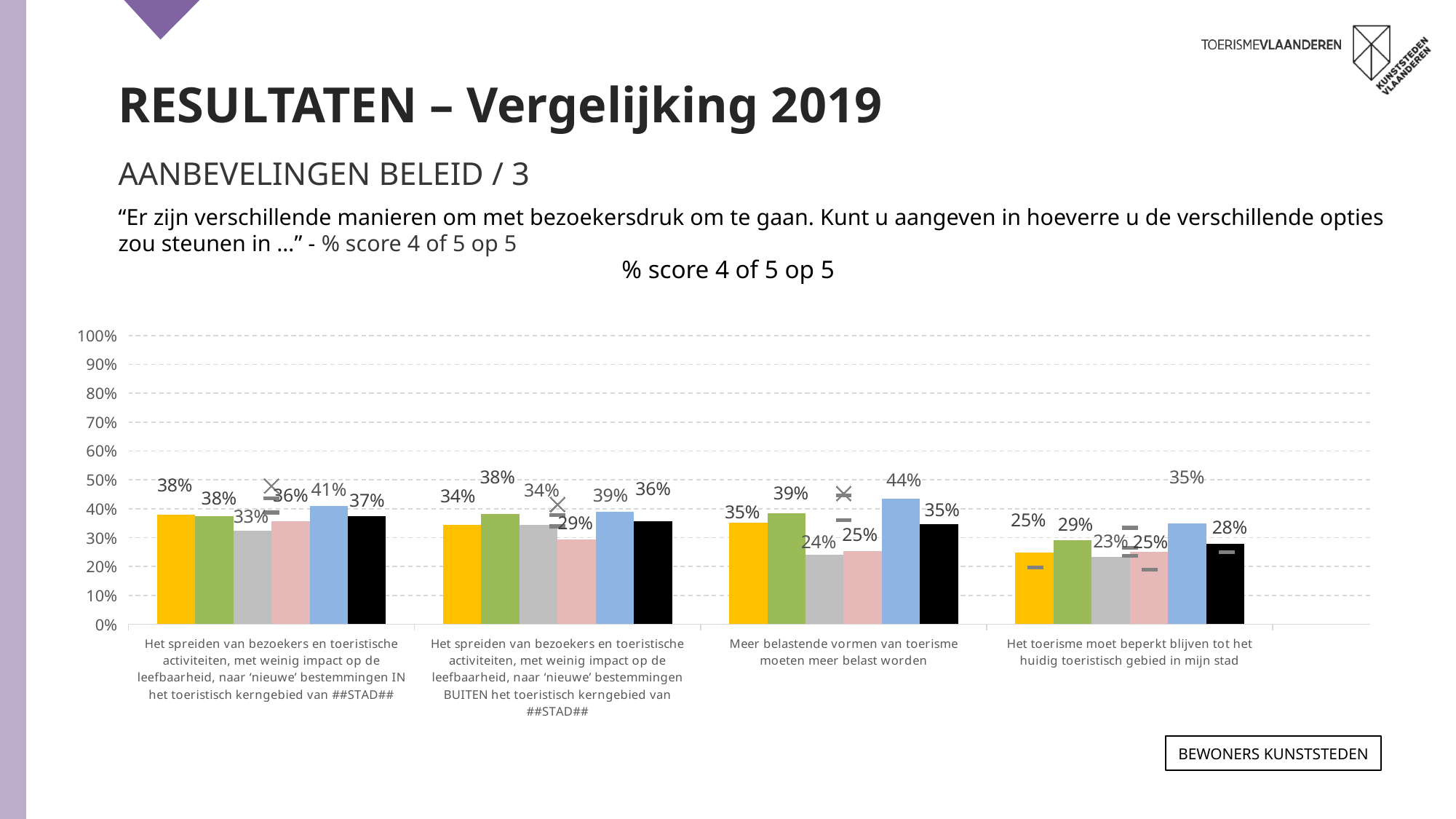
What is the title of the chart? % score 4 of 5 op 5 What is the difference between the blue bar (44%) and the grey bar (24%) for the category 'Meer belastende vormen van toerisme moeten meer belast worden'? 20% How many categories are shown along the x axis of the chart? 4 Is the value of the blue bar for the category 'Het spreiden van bezoekers ... IN het toeristisch kerngebied van ##STAD##' greater or less than 50%? less For the category 'Het toerisme moet beperkt blijven tot het huidig toeristisch gebied in mijn stad', which is larger: the green bar or the black bar? the green bar What kind of chart is shown on the slide? bar chart What is the value of the blue bar for the category 'Meer belastende vormen van toerisme moeten meer belast worden'? 44% Which category has the lowest yellow bar? Het toerisme moet beperkt blijven tot het huidig toeristisch gebied in mijn stad Which category has the highest blue bar? Meer belastende vormen van toerisme moeten meer belast worden What is the value of the black bar for the category 'Het spreiden van bezoekers ... IN het toeristisch kerngebied van ##STAD##'? 37% What is the value of the pink bar for the category 'Het spreiden van bezoekers en toeristische activiteiten ... BUITEN het toeristisch kerngebied van ##STAD##'? 29% What is the value of the grey bar for the category 'Het toerisme moet beperkt blijven tot het huidig toeristisch gebied in mijn stad'? 23%